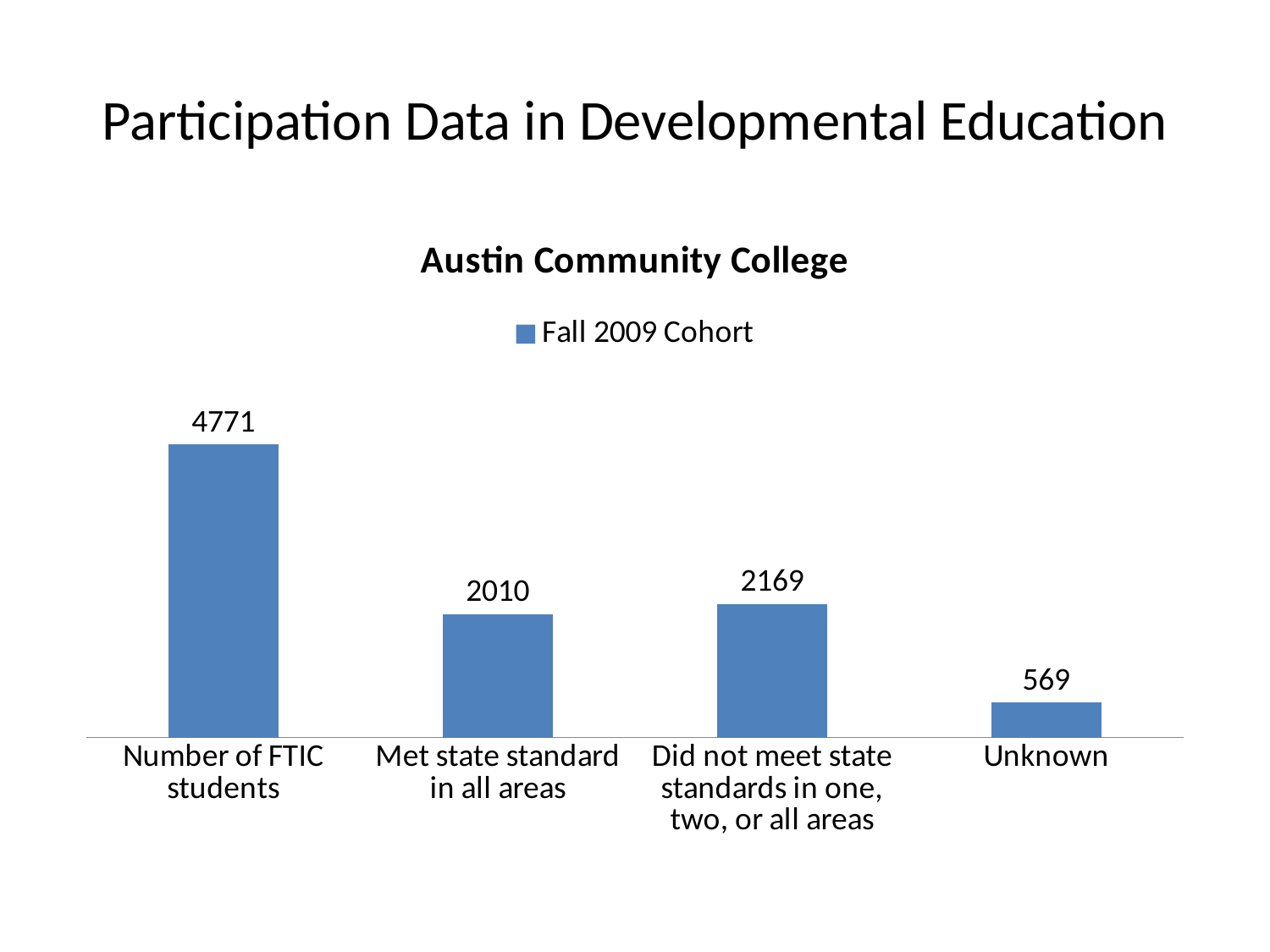
What kind of chart is shown on the slide? Bar chart What is the difference between the values for Did not meet state standards in one, two, or all areas and Met state standard in all areas? 159 What is the value for Did not meet state standards in one, two, or all areas? 2169 What series does the legend list? Fall 2009 Cohort Which category has the lowest value? Unknown What is the value for Met state standard in all areas? 2010 What is the value for Unknown? 569 How many categories are shown on the chart? 4 Which category has the highest value? Number of FTIC students Which is larger, the value for Met state standard in all areas or the value for Did not meet state standards in one, two, or all areas? Did not meet state standards in one, two, or all areas What is the value for Number of FTIC students? 4771 What is the difference between the values for Number of FTIC students and Unknown? 4202